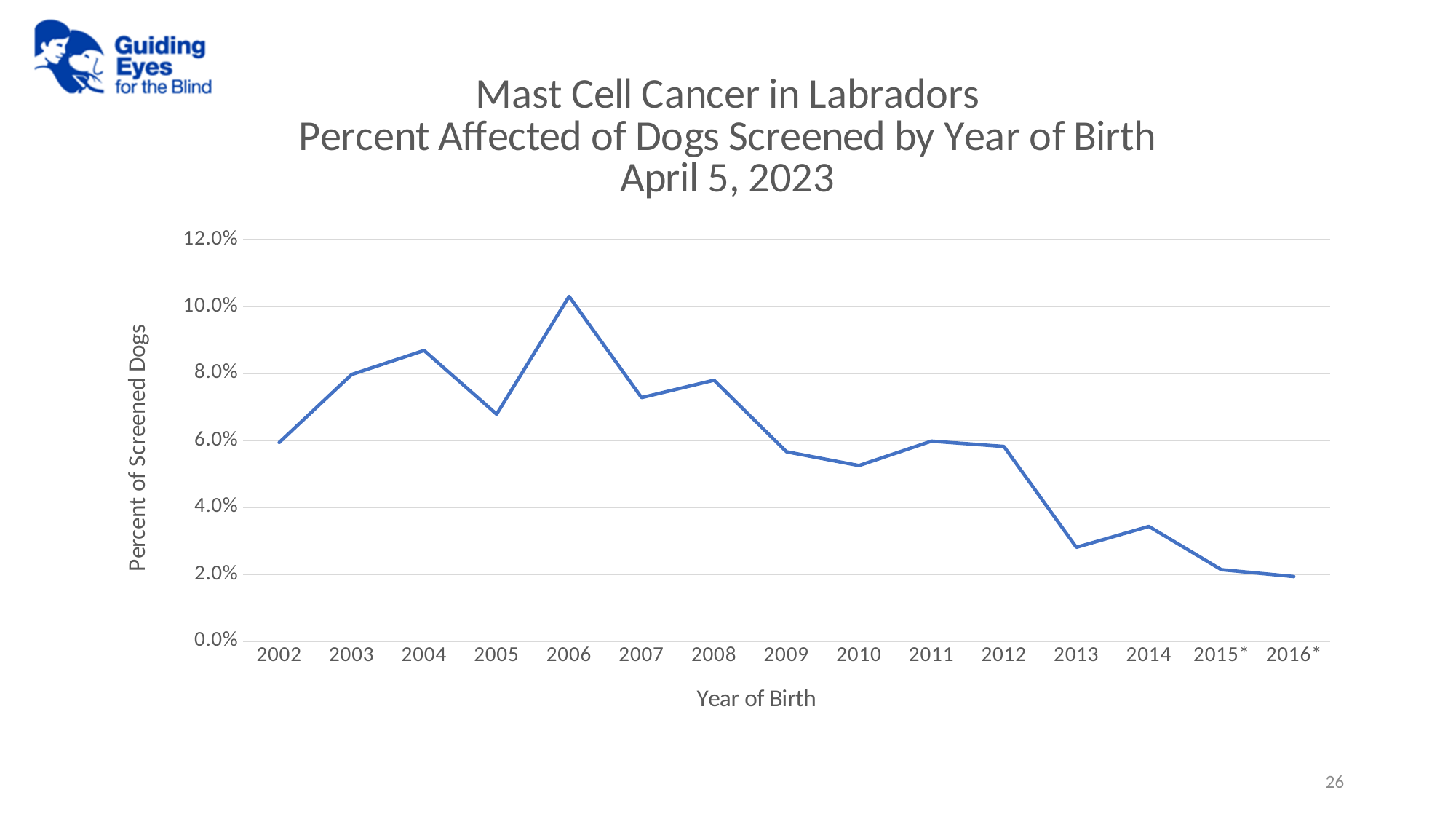
Is the value for 2006 greater or less than 10.0%? greater How many years of birth are plotted on the x axis? 15 Is the value for 2009 greater or less than 6.0%? less Which has a higher percent affected, 2013 or 2014? 2014 Which year of birth has the lowest percent of screened dogs affected? 2016* Is the value for 2013 greater or less than 4.0%? less What kind of chart is shown on the slide? line chart Which year of birth has the highest percent of screened dogs affected? 2006 Which has a higher percent affected, 2004 or 2005? 2004 What is the label on the y axis? Percent of Screened Dogs Do the values generally rise or fall from 2006 to 2016*? fall